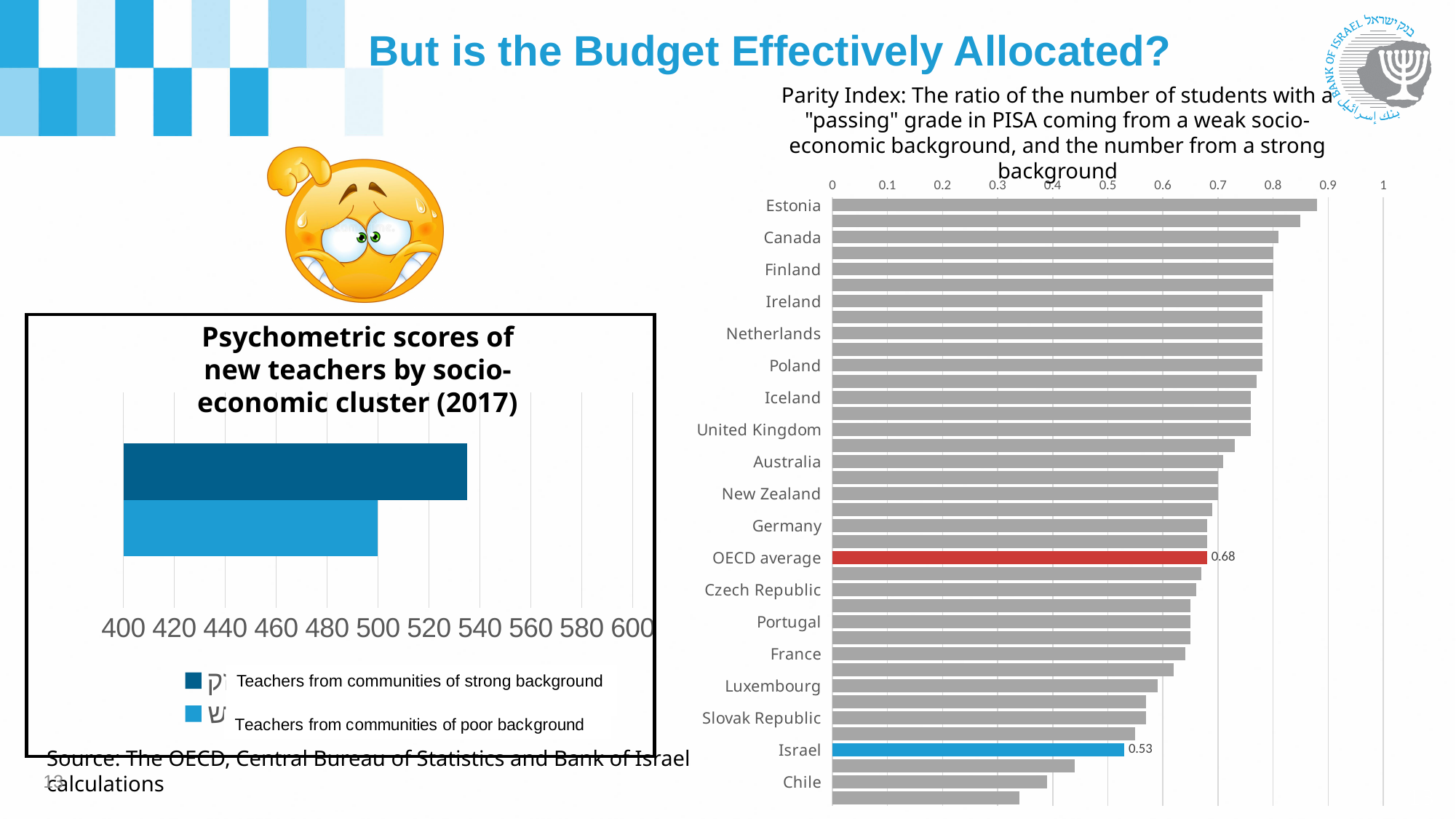
In the Parity Index chart, what is the difference between the OECD average and Israel? 0.15 In the 'Psychometric scores of new teachers' chart, is the score for teachers from communities of strong background greater or less than 520? greater In the 'Psychometric scores of new teachers' chart, is the score for teachers from communities of poor background greater or less than 520? less In the 'Psychometric scores of new teachers' chart, which group has the higher score: teachers from communities of strong background or teachers from communities of poor background? Teachers from communities of strong background What kind of chart is the 'Psychometric scores of new teachers by socio-economic cluster (2017)' chart? bar chart In the Parity Index chart, what colour is the bar for Israel? blue In the Parity Index chart, is the value for Chile greater or less than 0.5? less In the Parity Index chart, which labeled country has the highest value? Estonia In the Parity Index chart, what is the value for Israel? 0.53 How many series does the legend of the 'Psychometric scores of new teachers' chart list? 2 In the Parity Index chart, what is the value for the OECD average? 0.68